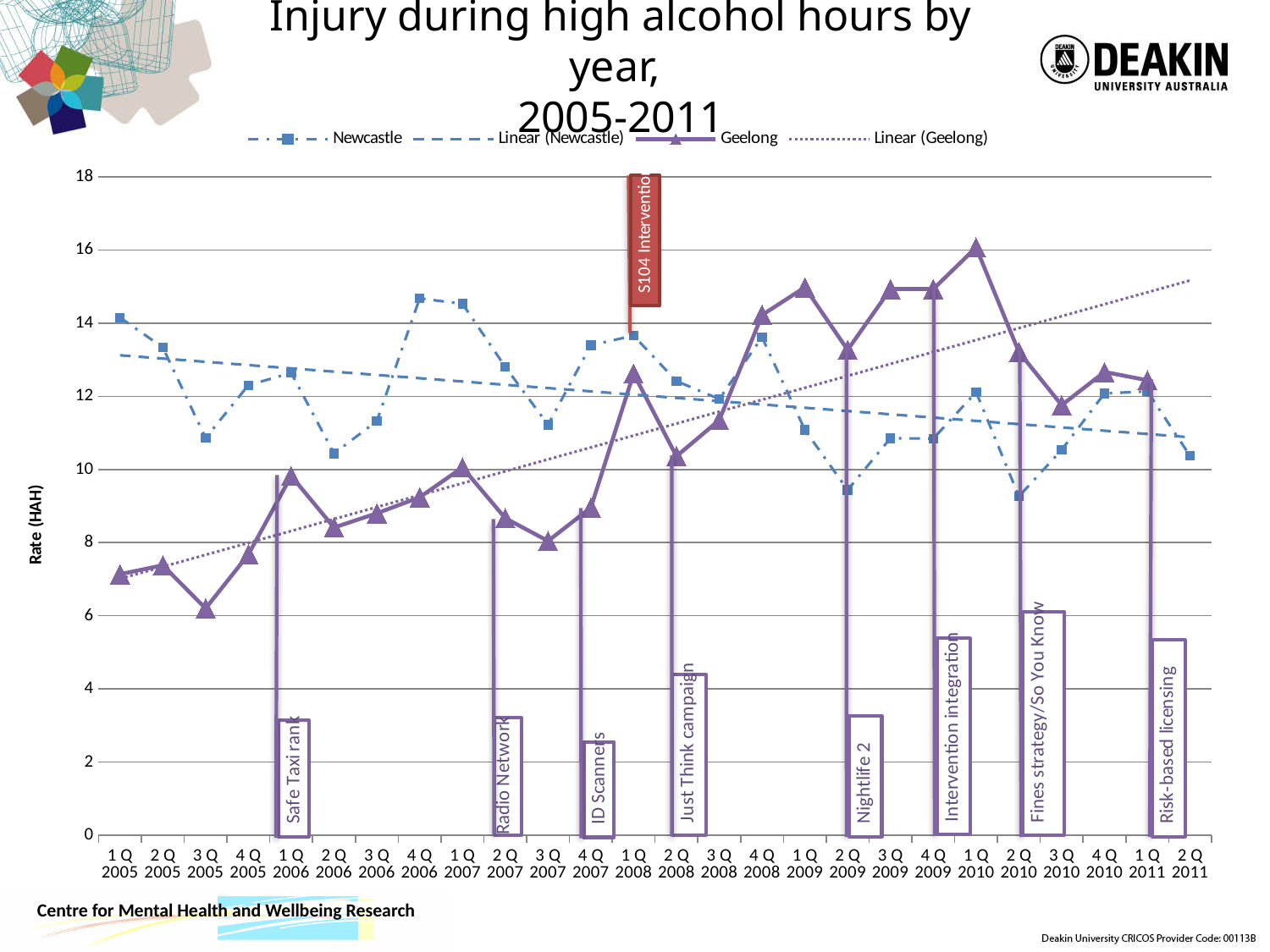
Is the Newcastle value for 2 Q 2009 greater or less than 10? less In 1 Q 2010, which series has the higher value, Newcastle or Geelong? Geelong Is the Newcastle value for 4 Q 2006 greater or less than 14? greater How many entries does the chart legend list? 4 Does the Linear (Geelong) trendline rise or fall from 2005 to 2011? Rises Is the Geelong value for 1 Q 2005 greater or less than 8? less How many quarterly points are plotted along the x axis? 26 In which quarter does the Geelong series reach its highest value? 1 Q 2010 In 1 Q 2005, which series has the higher value, Newcastle or Geelong? Newcastle In which quarter does the Geelong series reach its lowest value? 3 Q 2005 What kind of chart is shown on the slide? Line chart